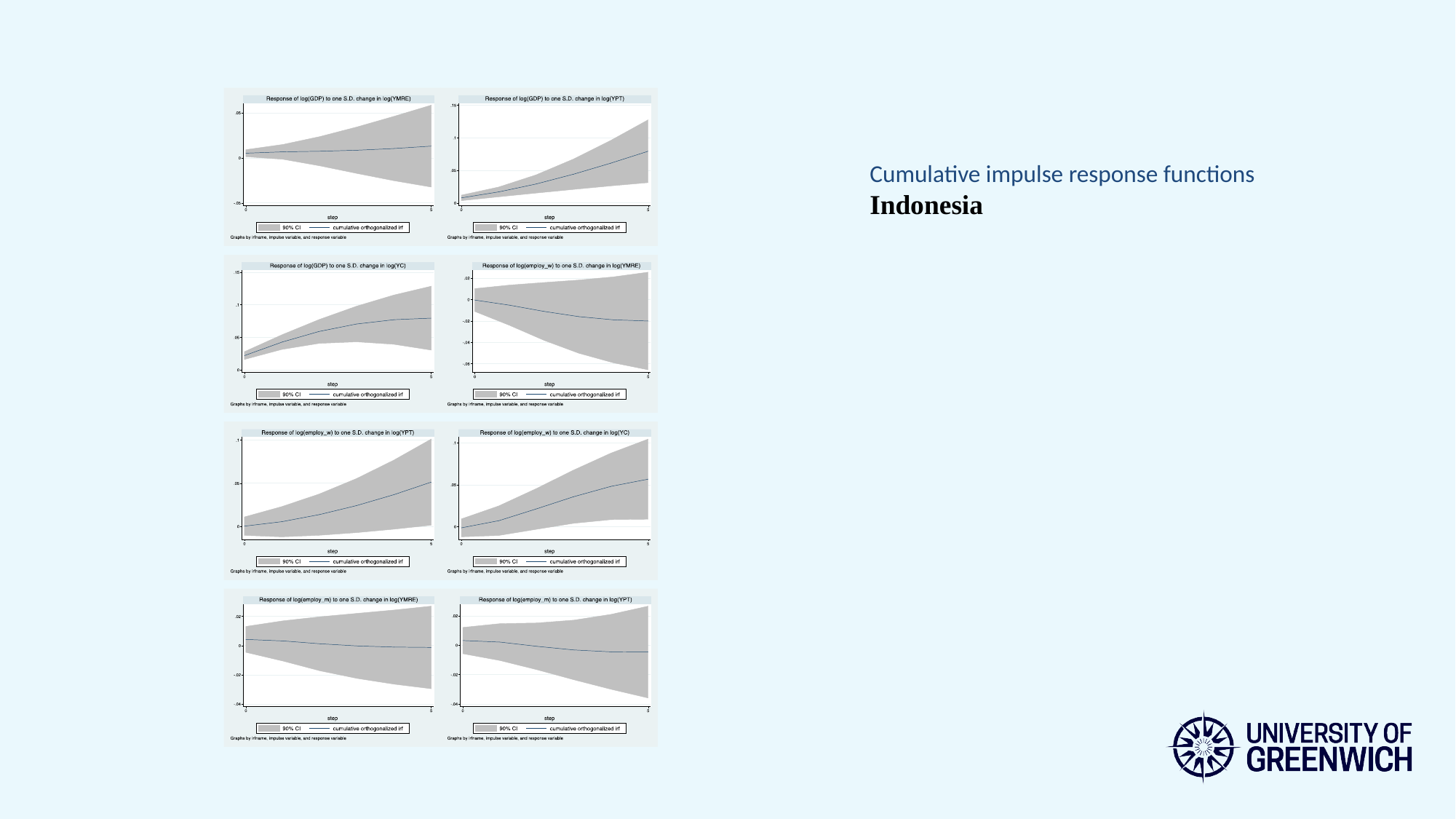
In the 'Response of log(GDP) to one S.D. change in log(YC)' chart, does the cumulative orthogonalized irf line rise or fall as step increases? rise What confidence interval level is shown in the legend of the charts? 90% CI In the 'Response of log(GDP) to one S.D. change in log(YPT)' chart, is the cumulative orthogonalized irf value at step 5 greater or less than .05? greater In the 'Response of log(GDP) to one S.D. change in log(YPT)' chart, does the cumulative orthogonalized irf line rise or fall as step increases? rise In the 'Response of log(GDP) to one S.D. change in log(YC)' chart, is the cumulative orthogonalized irf value at step 5 greater or less than .05? greater In the 'Response of log(employ_w) to one S.D. change in log(YPT)' chart, does the cumulative orthogonalized irf line rise or fall as step increases? rise How many charts are shown on the slide? 8 How many entries does the legend of the 'Response of log(GDP) to one S.D. change in log(YC)' chart list? 2 What kind of chart is the 'Response of log(GDP) to one S.D. change in log(YPT)' chart? line chart In the 'Response of log(employ_w) to one S.D. change in log(YMRE)' chart, is the cumulative orthogonalized irf value at step 5 greater or less than 0? less What is the x-axis label on the 'Response of log(employ_m) to one S.D. change in log(YPT)' chart? step